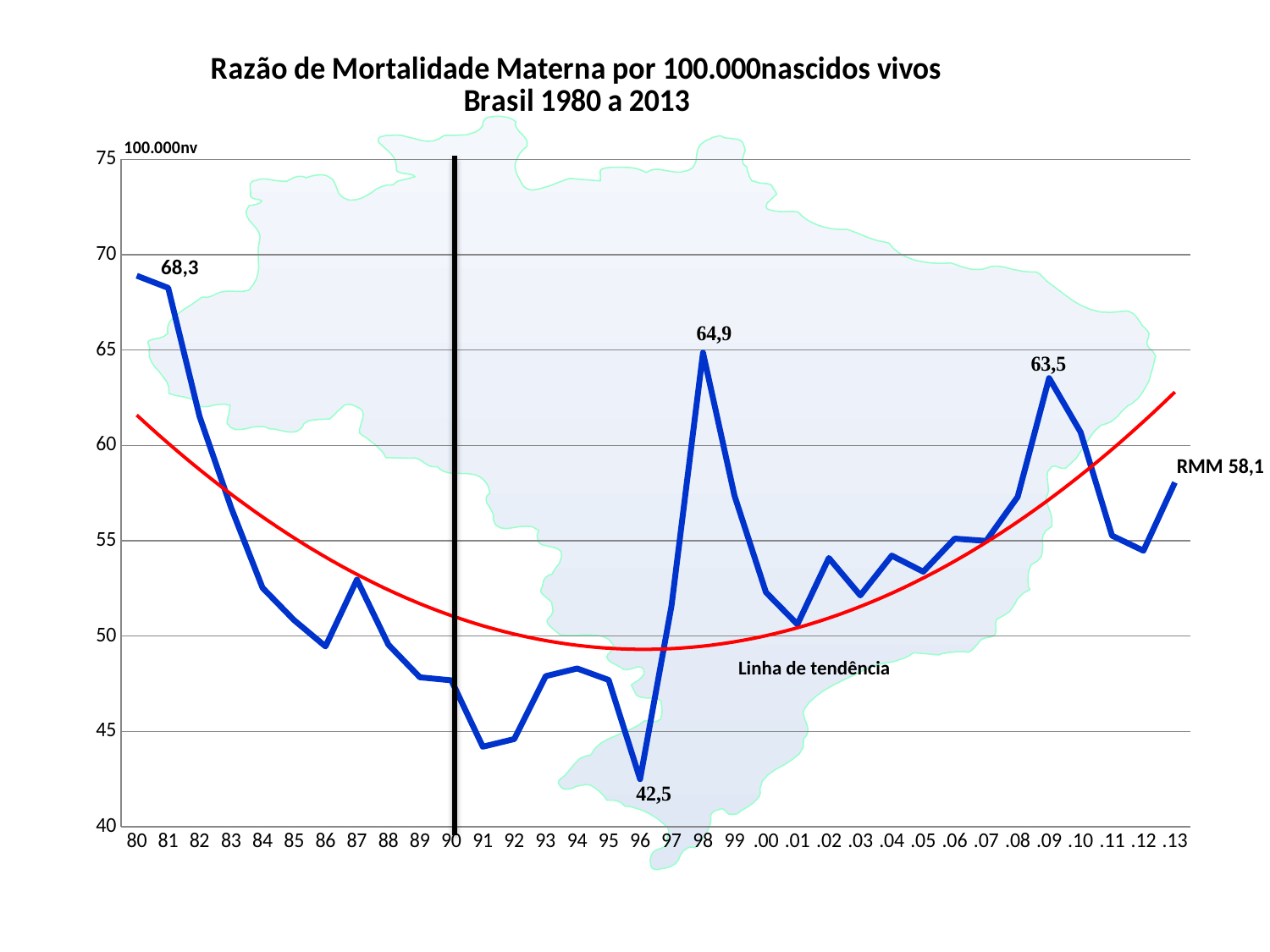
Is the value for 87 greater or less than 50? greater Which year has the lowest value on the line? 96 Which year has the larger labeled value, 98 or 09? 98 What is the difference between the labeled values for 98 and 96? 22,4 What is the RMM value labeled at the end of the series (13)? 58,1 Is the value for 84 greater or less than 55? less What kind of chart is shown on the slide? line chart What is the value labeled for 96? 42,5 What is the difference between the labeled values for 09 and 13? 5,4 What is the maternal mortality ratio value labeled for 98? 64,9 What is the value labeled for 09? 63,5 What is the red curve on the chart labeled as? Linha de tendência